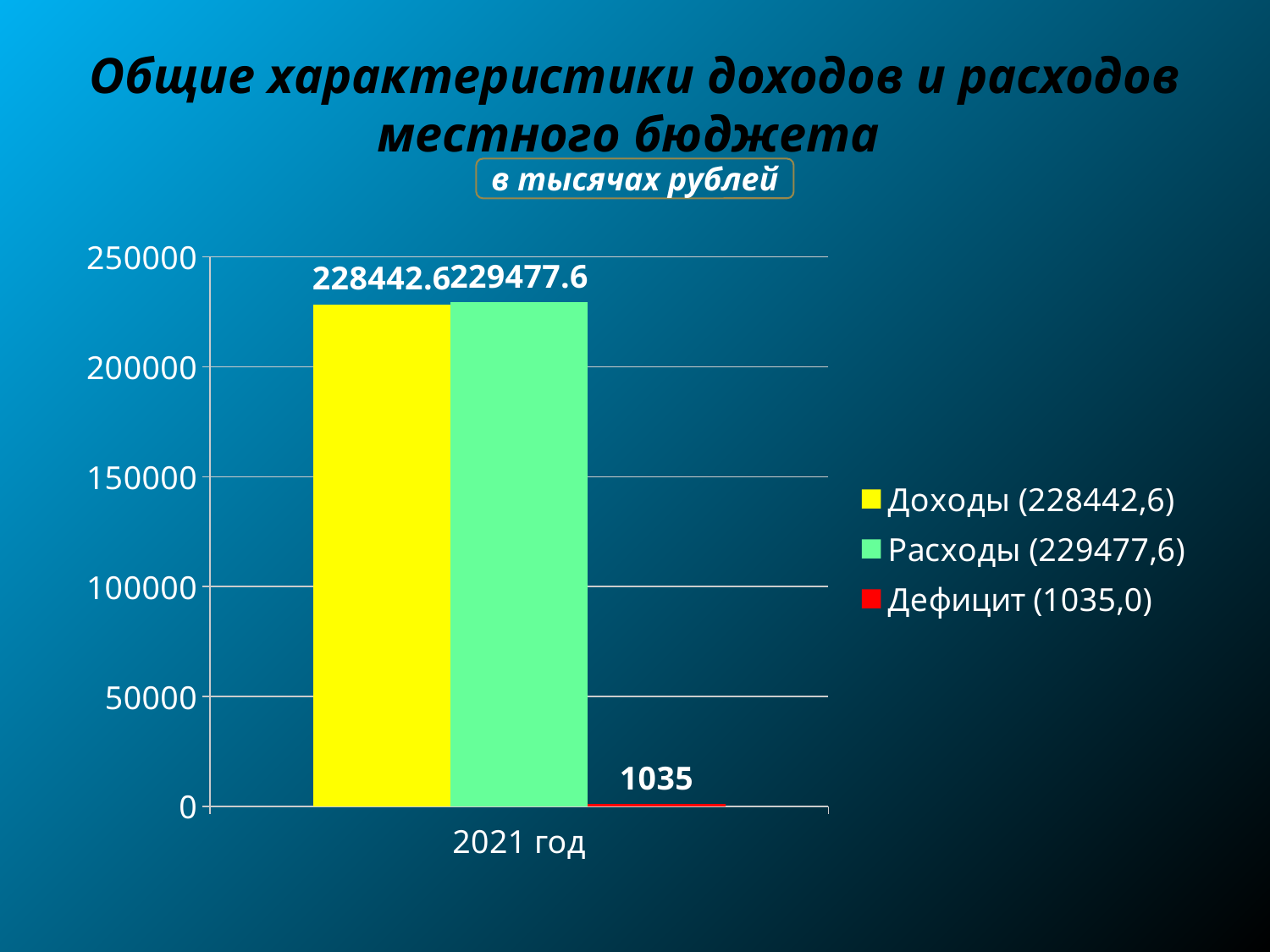
Which is larger, Доходы or Расходы? Расходы Is the value for Доходы greater or less than 200000? greater Is the value for Дефицит greater or less than 50000? less How many series does the legend list? 3 What is the value of Дефицит for 2021 год? 1035 What kind of chart is shown on the slide? bar chart What is the value of Расходы for 2021 год? 229477.6 Which series has the lowest value in the chart? Дефицит Which series has the highest value in the chart? Расходы What is the difference between Расходы and Доходы? 1035 What is the value of Доходы for 2021 год? 228442.6 What colour is the bar for Дефицит? red